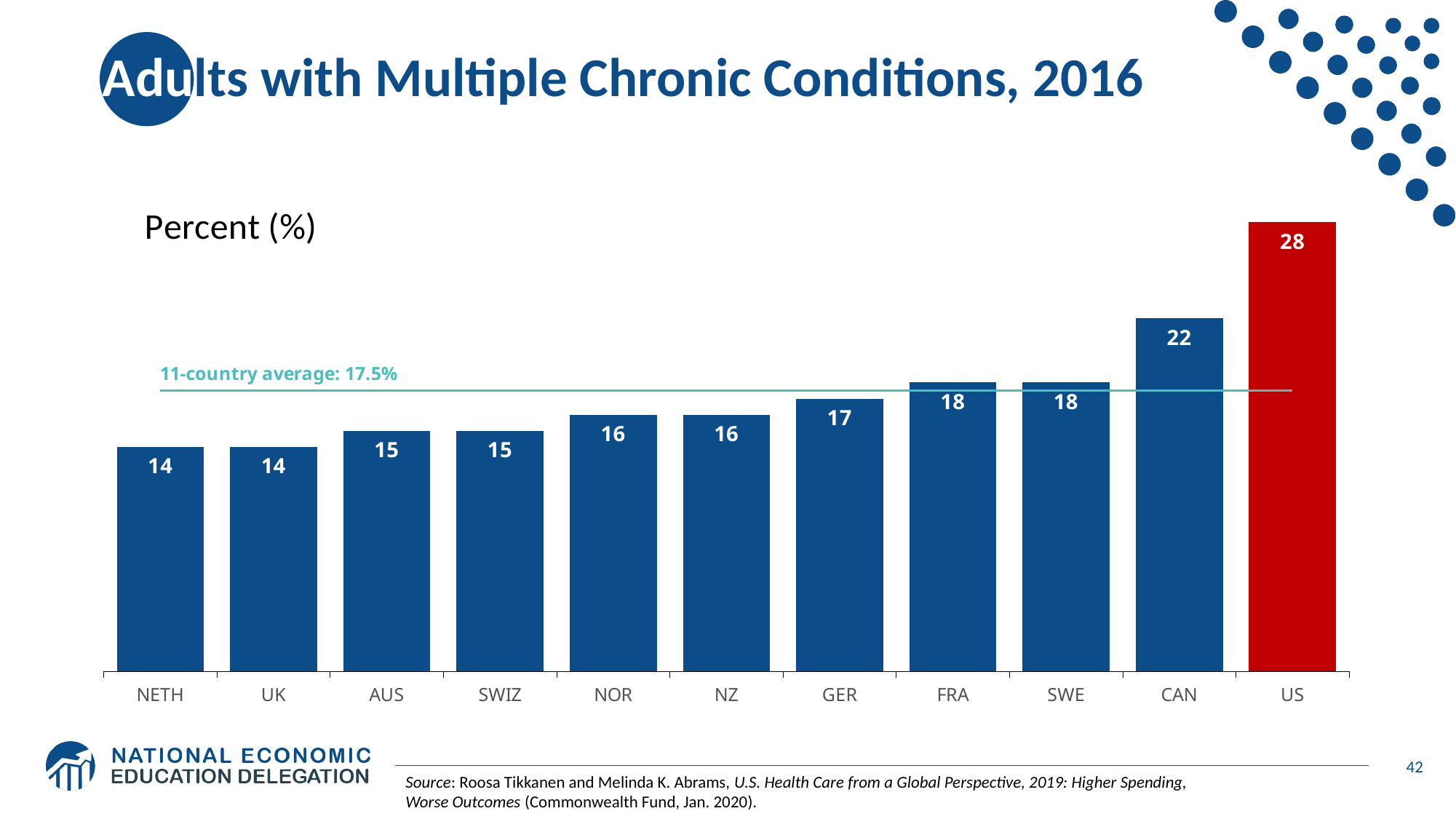
What is the value for GER? 17 What is the difference between the values for the US and CAN? 6 Which country's bar is coloured red? US What is the difference between the values for SWE and NETH? 4 Which country has the highest value? US How many countries are shown in the chart? 11 What is the 11-country average shown on the chart? 17.5% Which is larger, the value for NOR or the value for FRA? FRA Do the values rise or fall from left to right across the countries? rise What is the value for CAN? 22 What is the value for the US? 28 What kind of chart is shown on the slide? bar chart